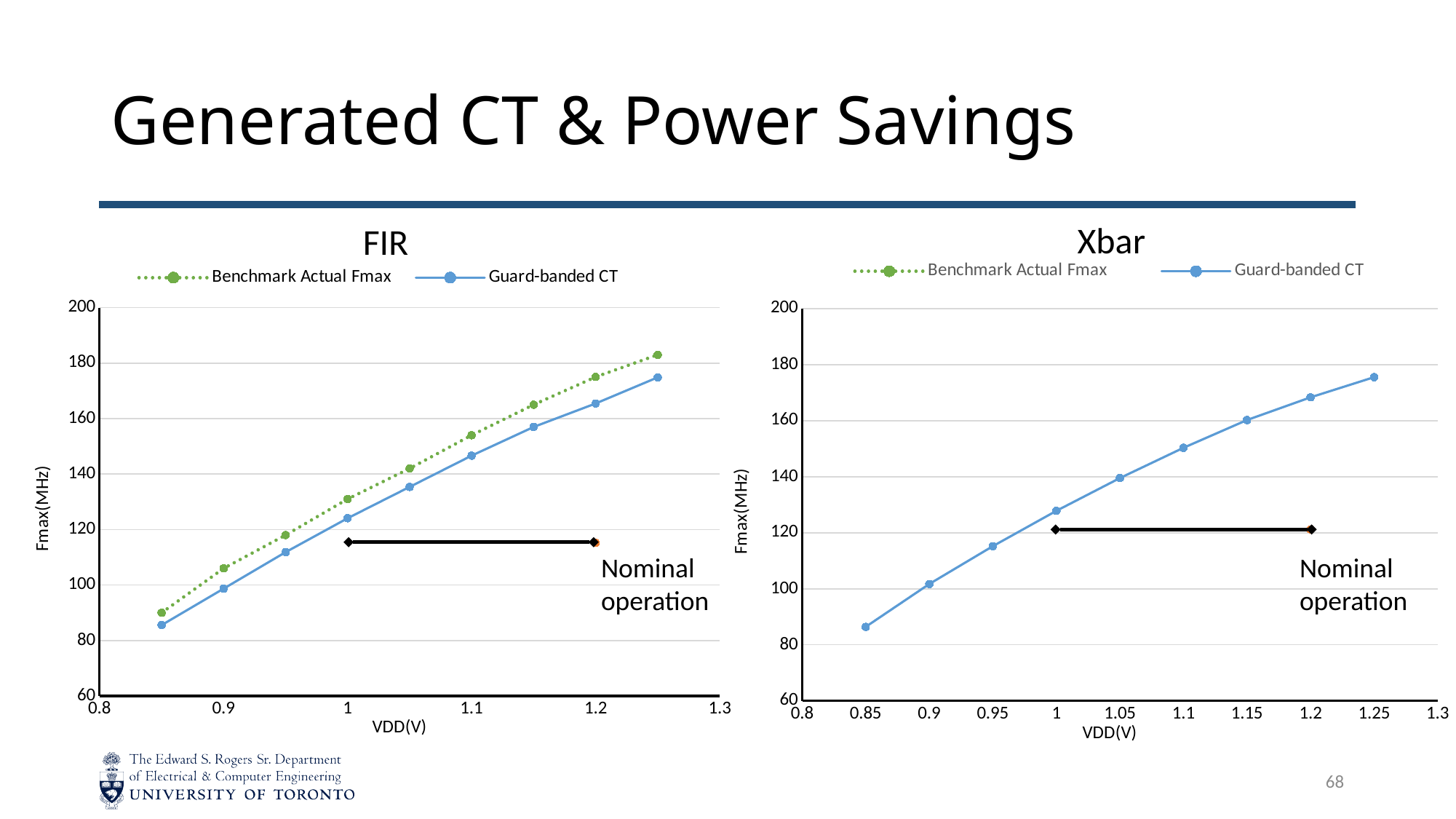
In the Xbar chart, at which VDD value is the Guard-banded CT series highest? 1.25 How many series does the legend of the FIR chart list? 2 What is the y-axis label of the Xbar chart? Fmax(MHz) In the Xbar chart, is the Guard-banded CT value at VDD 0.85 greater or less than 100? less In the FIR chart, at VDD 1.2, which series has the higher value: Benchmark Actual Fmax or Guard-banded CT? Benchmark Actual Fmax In the FIR chart, how many data points does the Guard-banded CT series have? 9 In the FIR chart, is the Guard-banded CT value at VDD 1.25 greater or less than 160? greater What kind of chart is the FIR chart? line chart In the FIR chart, do the Guard-banded CT values rise or fall as VDD increases? rise In the FIR chart, at which VDD value is the Guard-banded CT series lowest? 0.85 In the Xbar chart, is the Guard-banded CT value at VDD 1.1 greater or less than 140? greater